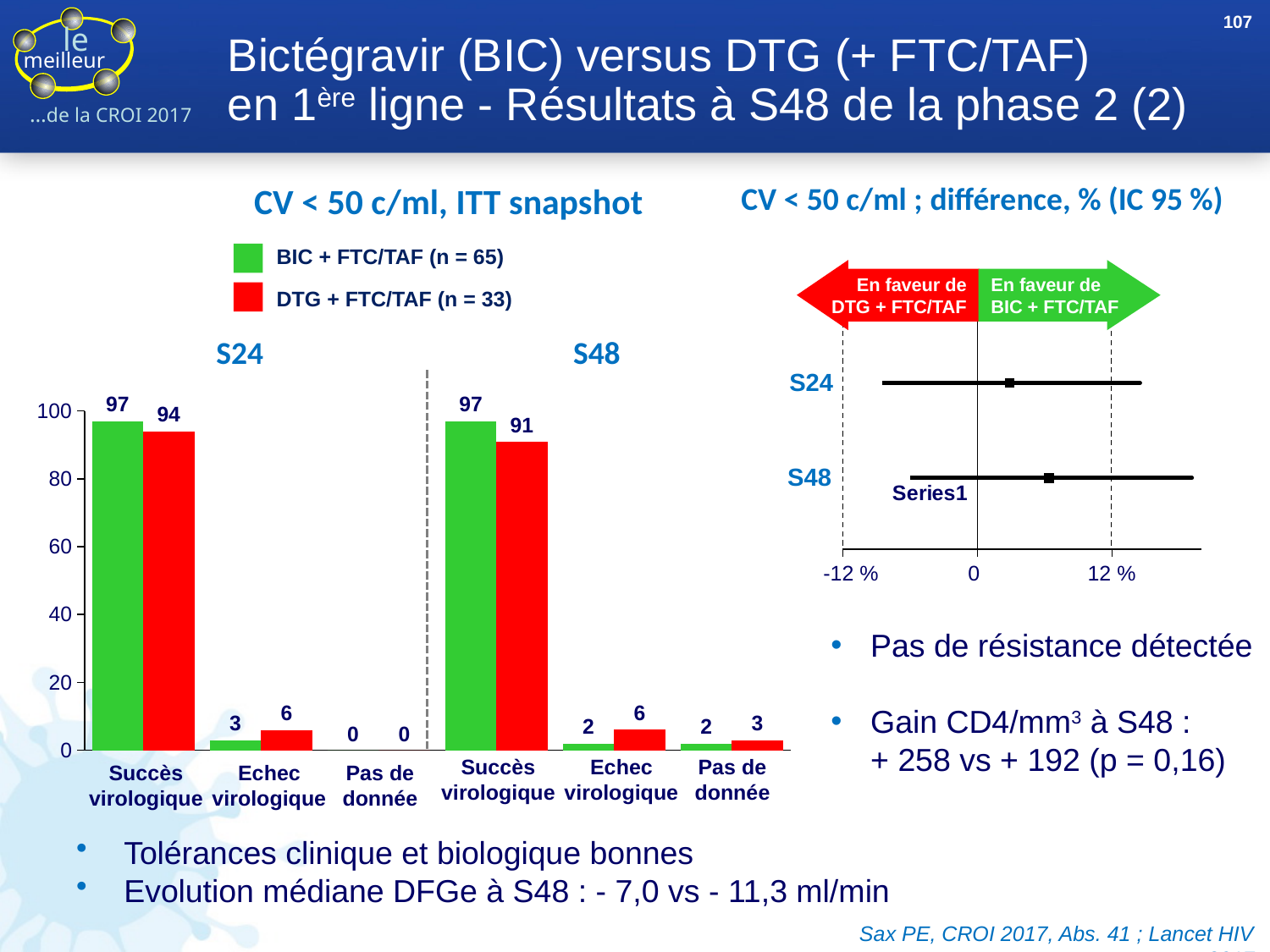
In the bar chart titled "CV < 50 c/ml, ITT snapshot", what is the value for DTG + FTC/TAF for Succès virologique at S48? 91 In the bar chart titled "CV < 50 c/ml, ITT snapshot", which series has the higher value for Succès virologique at S24? BIC + FTC/TAF In the chart on the right titled "CV < 50 c/ml ; différence, % (IC 95 %)", is the point estimate for S48 greater or less than 0? greater In the bar chart titled "CV < 50 c/ml, ITT snapshot", how many series does the legend list? 2 In the bar chart titled "CV < 50 c/ml, ITT snapshot", what is the difference between BIC + FTC/TAF and DTG + FTC/TAF for Succès virologique at S48? 6 In the bar chart titled "CV < 50 c/ml, ITT snapshot", what is the value for BIC + FTC/TAF for Succès virologique at S24? 97 In the bar chart titled "CV < 50 c/ml, ITT snapshot", what is the value for DTG + FTC/TAF for Echec virologique at S24? 6 In the bar chart titled "CV < 50 c/ml, ITT snapshot", which series has the higher value for Echec virologique at S48? DTG + FTC/TAF In the bar chart titled "CV < 50 c/ml, ITT snapshot", what colour represents DTG + FTC/TAF? Red In the bar chart titled "CV < 50 c/ml, ITT snapshot", what is the value for BIC + FTC/TAF for Pas de donnée at S48? 2 In the bar chart titled "CV < 50 c/ml, ITT snapshot", what is the difference between DTG + FTC/TAF and BIC + FTC/TAF for Echec virologique at S48? 4 In the bar chart titled "CV < 50 c/ml, ITT snapshot", what kind of chart is it? Bar chart